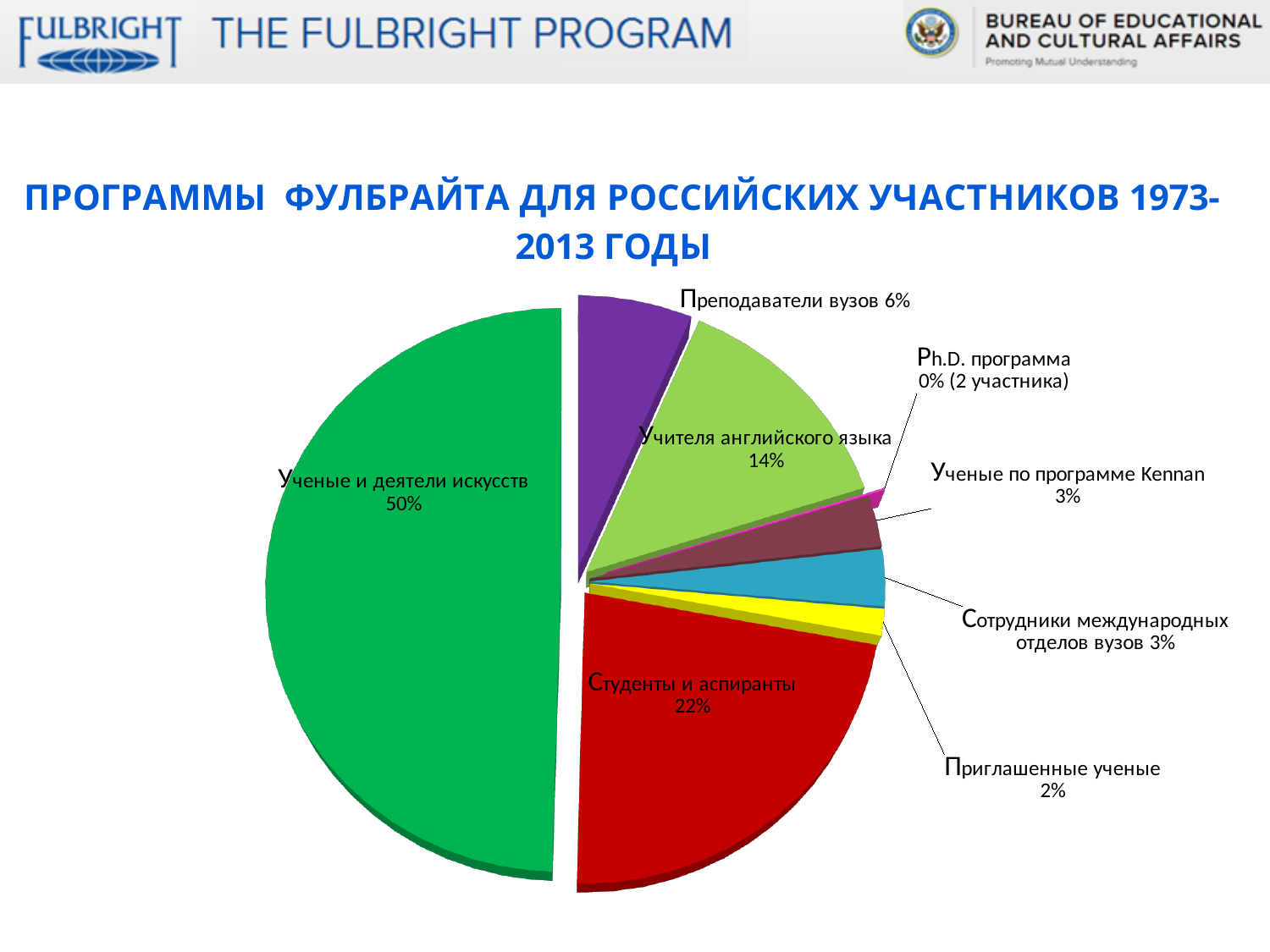
Which category has the largest share of the pie? Ученые и деятели искусств Which is larger, the share for "Учителя английского языка" or for "Преподаватели вузов"? Учителя английского языка What kind of chart is shown on the slide? pie chart What percentage is shown for "Приглашенные ученые"? 2% What share of the pie is labelled for "Ученые и деятели искусств"? 50% What percentage is shown for "Учителя английского языка"? 14% What is the label shown for the "Ph.D. программа" slice? 0% (2 участника) What is the difference in percentage points between "Ученые и деятели искусств" and "Студенты и аспиранты"? 28 How many categories are shown in the pie chart? 8 Which category has the smallest share of the pie? Ph.D. программа What percentage is shown for "Преподаватели вузов"? 6% What percentage is shown for "Студенты и аспиранты"? 22%